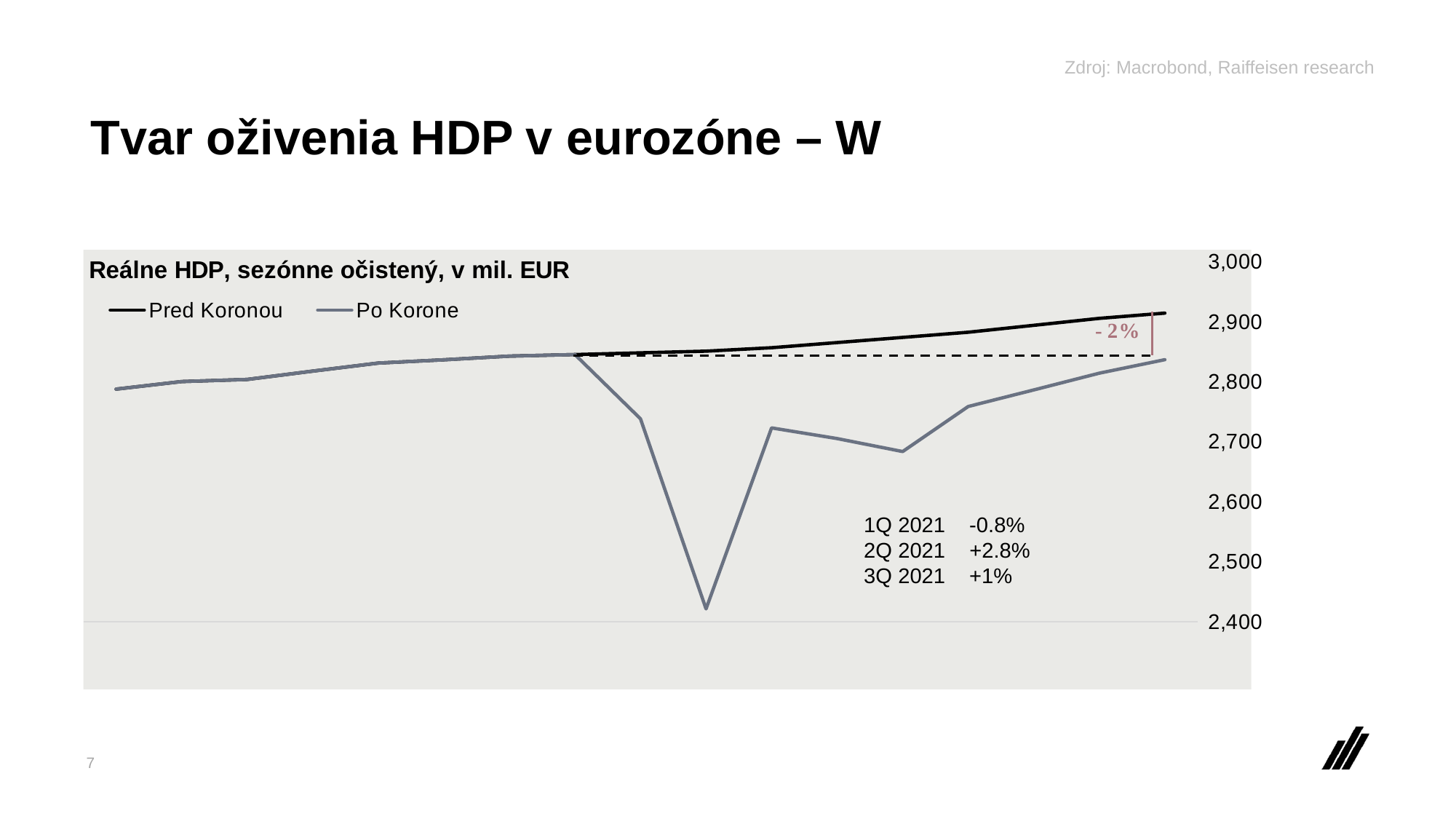
What is the title of the chart? Reálne HDP, sezónne očistený, v mil. EUR At the right end of the chart, which line is higher: Pred Koronou or Po Korone? Pred Koronou Is the final value of the Pred Koronou line greater or less than 2,900? greater Does the Pred Koronou line rise or fall along the x axis? rise What percentage gap is annotated between the Pred Koronou line and the Po Korone line at the right end of the chart? -2% What kind of chart is shown on the slide? line chart What growth value is shown on the chart for 1Q 2021? -0.8% Is the lowest point of the Po Korone line greater or less than 2,500? less What are the two series named in the chart legend? Pred Koronou and Po Korone What growth value is shown on the chart for 2Q 2021? +2.8% Is the first value of the Po Korone line greater or less than 2,800? less How many series does the chart legend list? 2